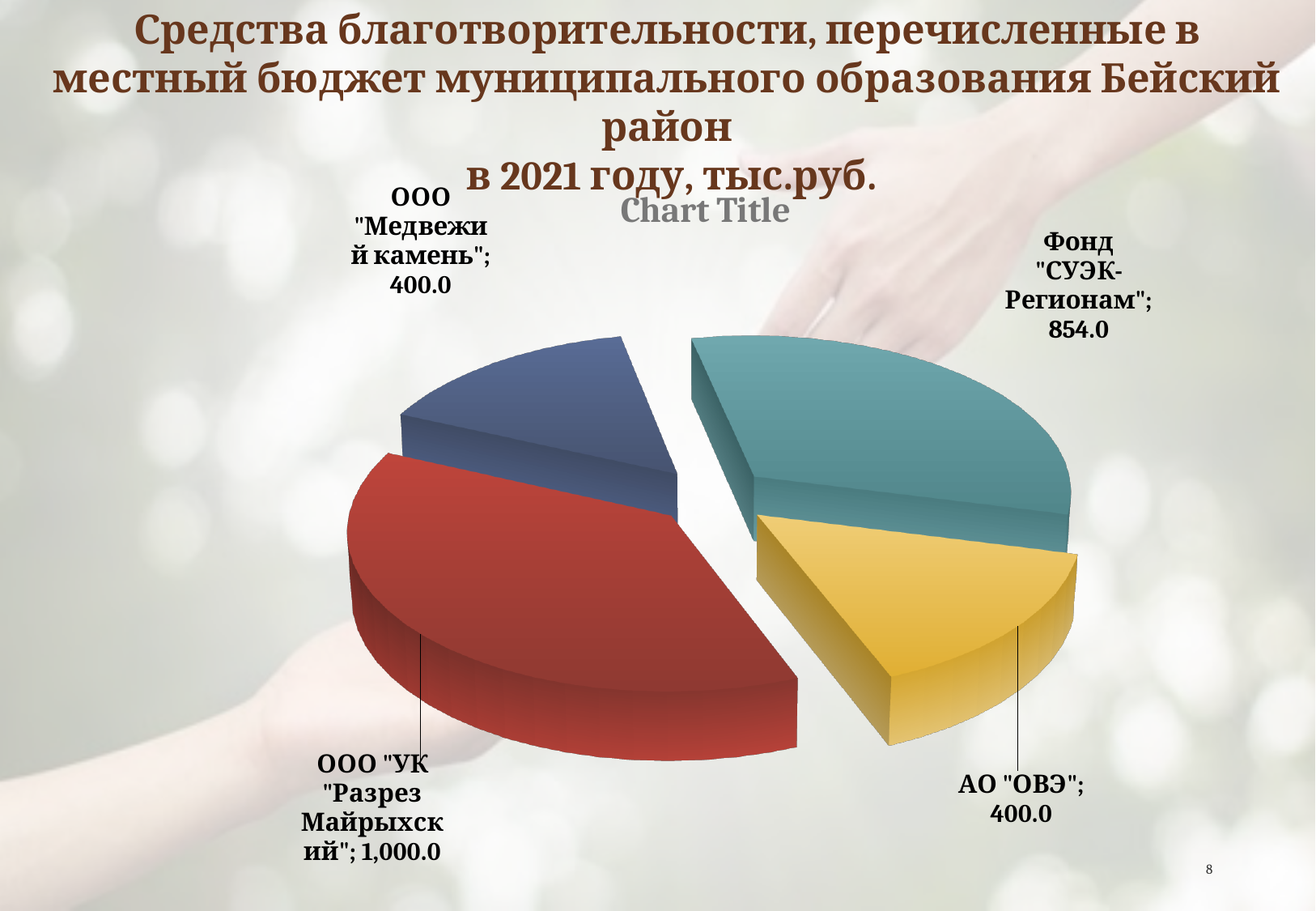
What is the value for Фонд "СУЭК-Регионам"? 854.0 What is the value for АО "ОВЭ"? 400.0 What share of the total does ООО "УК "Разрез Майрыхский" represent? 37.7% What is the total of all the values shown in the pie chart? 2,654.0 What is the value for ООО "УК "Разрез Майрыхский"? 1,000.0 What colour is the slice for Фонд "СУЭК-Регионам"? Teal Which contributor has the largest slice of the pie? ООО "УК "Разрез Майрыхский" What type of chart is shown on the slide? Pie chart Which is larger, the value for Фонд "СУЭК-Регионам" or the value for АО "ОВЭ"? Фонд "СУЭК-Регионам" How many slices does the pie chart have? 4 What is the value for ООО "Медвежий камень"? 400.0 What is the difference between the values for ООО "УК "Разрез Майрыхский" and Фонд "СУЭК-Регионам"? 146.0